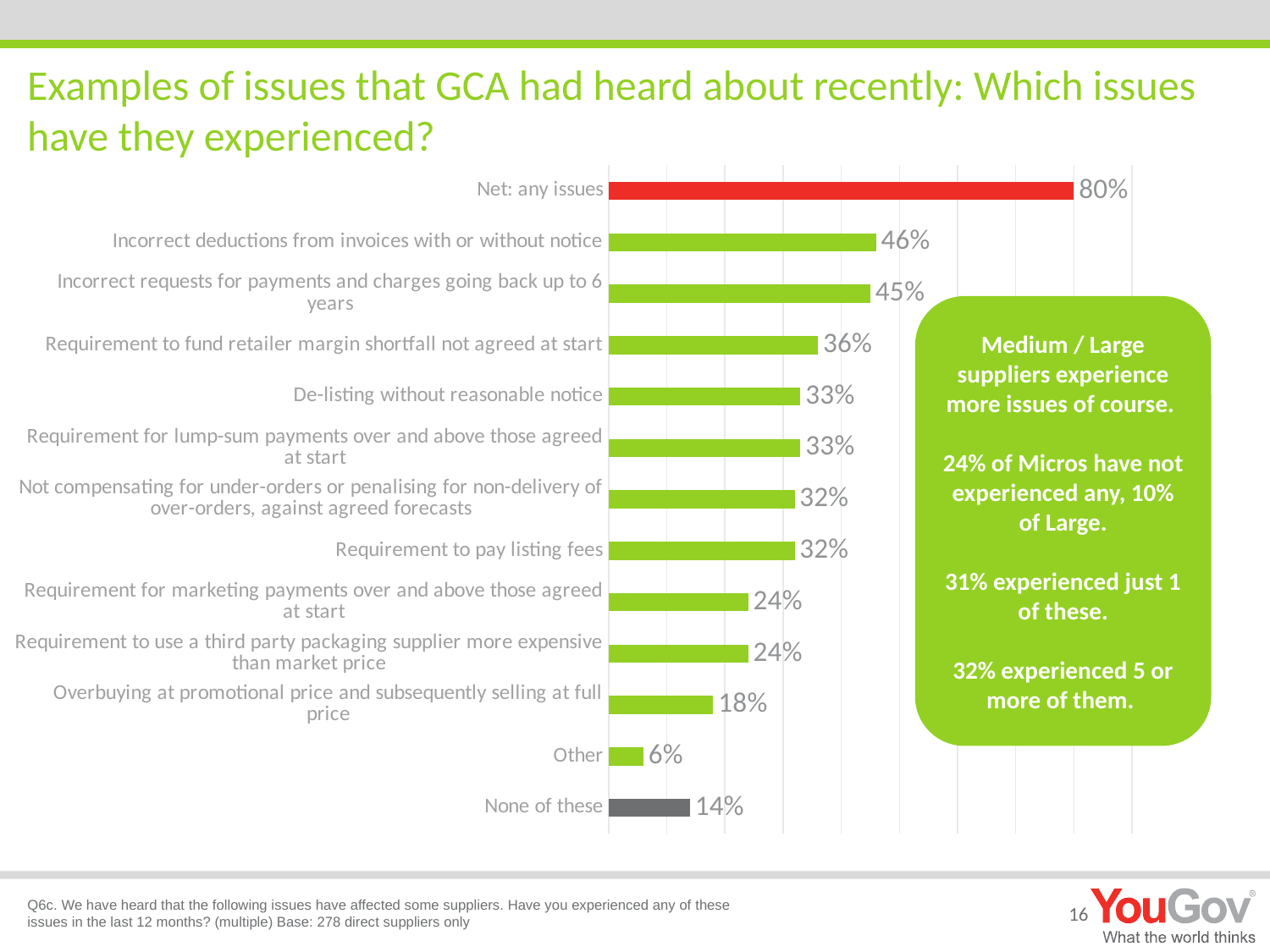
What is the difference between "Net: any issues" and "None of these"? 66% Excluding the "Net: any issues" bar, which specific issue has the highest value? Incorrect deductions from invoices with or without notice Which is larger: the value for "Requirement to fund retailer margin shortfall not agreed at start" or the value for "Requirement for marketing payments over and above those agreed at start"? Requirement to fund retailer margin shortfall not agreed at start What is the difference between "Incorrect deductions from invoices with or without notice" and "Requirement to pay listing fees"? 14% What colour is the bar for "Net: any issues"? Red What kind of chart is shown on the slide? Bar chart How many categories are shown on the chart? 13 What is the value for "Overbuying at promotional price and subsequently selling at full price"? 18% What is the value for "Net: any issues"? 80% What percentage of suppliers experienced "De-listing without reasonable notice"? 33% What is the value for "None of these"? 14% Which category has the lowest value on the chart? Other